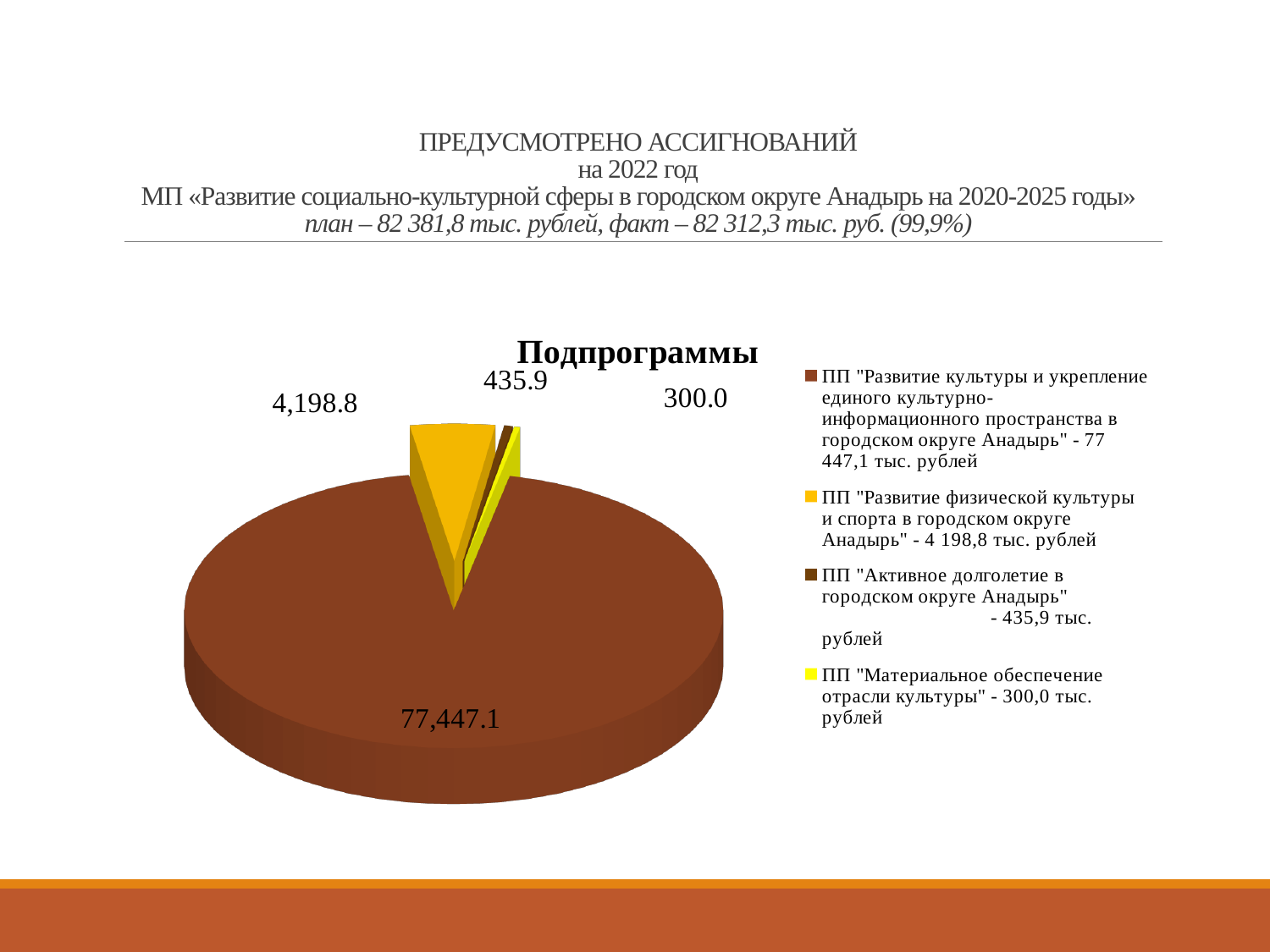
How many entries does the legend list? 4 What value is shown for ПП "Материальное обеспечение отрасли культуры"? 300.0 What value is shown for ПП "Развитие физической культуры и спорта в городском округе Анадырь"? 4,198.8 What value is shown for ПП "Активное долголетие в городском округе Анадырь"? 435.9 What is the title of the chart? Подпрограммы Which subprogram has the largest slice of the pie? ПП "Развитие культуры и укрепление единого культурно-информационного пространства в городском округе Анадырь" Which is larger: the value for ПП "Активное долголетие в городском округе Анадырь" or for ПП "Материальное обеспечение отрасли культуры"? ПП "Активное долголетие в городском округе Анадырь" Which subprogram has the smallest slice of the pie? ПП "Материальное обеспечение отрасли культуры" How many slices does the pie chart have? 4 What kind of chart is shown on the slide? pie chart What value is shown for ПП "Развитие культуры и укрепление единого культурно-информационного пространства в городском округе Анадырь"? 77,447.1 What is the difference between the values for ПП "Развитие физической культуры и спорта в городском округе Анадырь" and ПП "Материальное обеспечение отрасли культуры"? 3,898.8